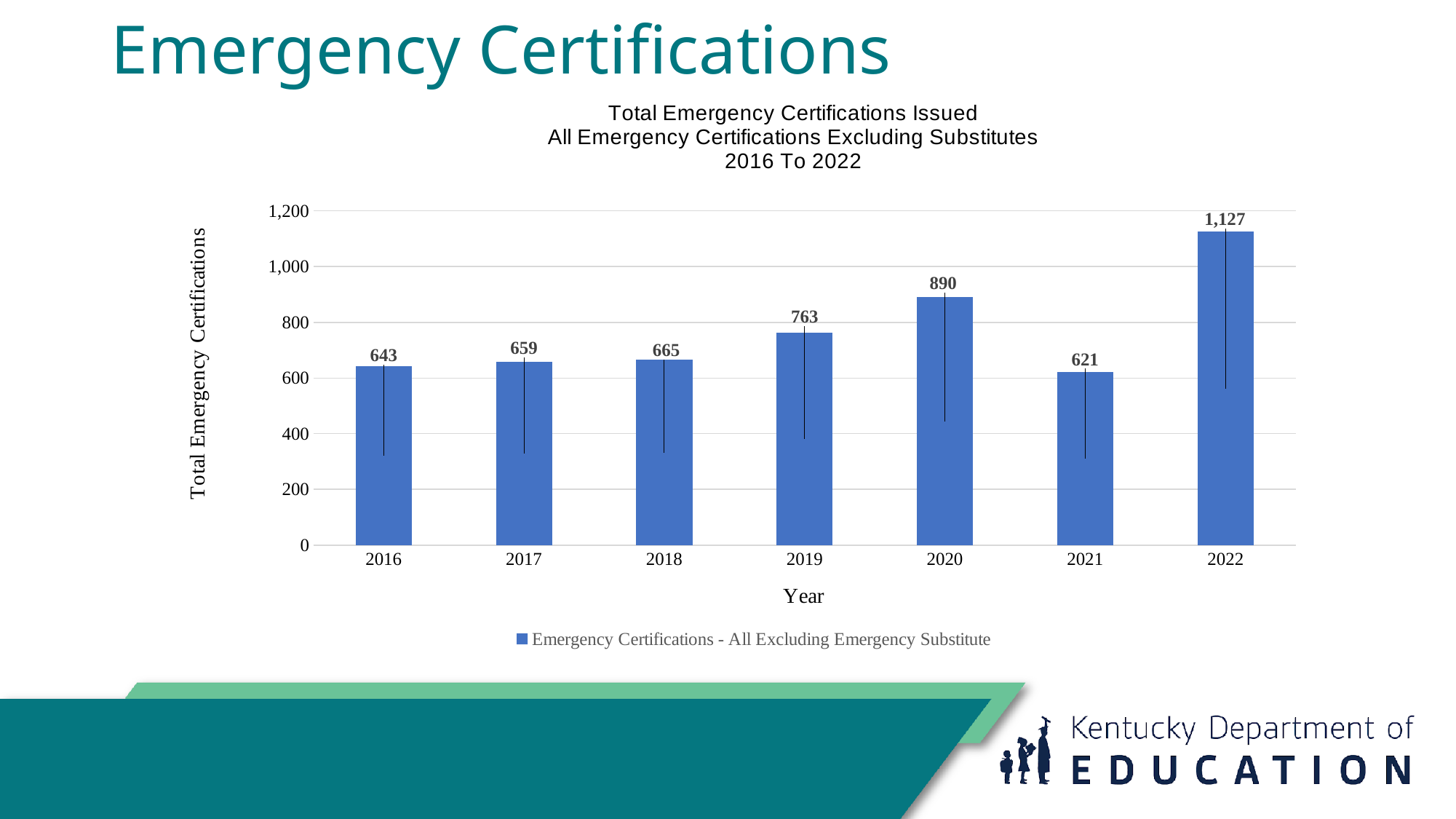
Which year has the lowest value? 2021 Which year has the highest value? 2022 What is the value for 2022? 1,127 How many years are shown on the x axis? 7 Is the value for 2020 greater or less than 800? greater What is the value for 2020? 890 How many series does the legend list? 1 What is the value for 2016? 643 What kind of chart is shown? bar chart What is the difference between the values for 2022 and 2021? 506 What is the label of the y axis? Total Emergency Certifications Which is larger, the value for 2019 or the value for 2018? 2019